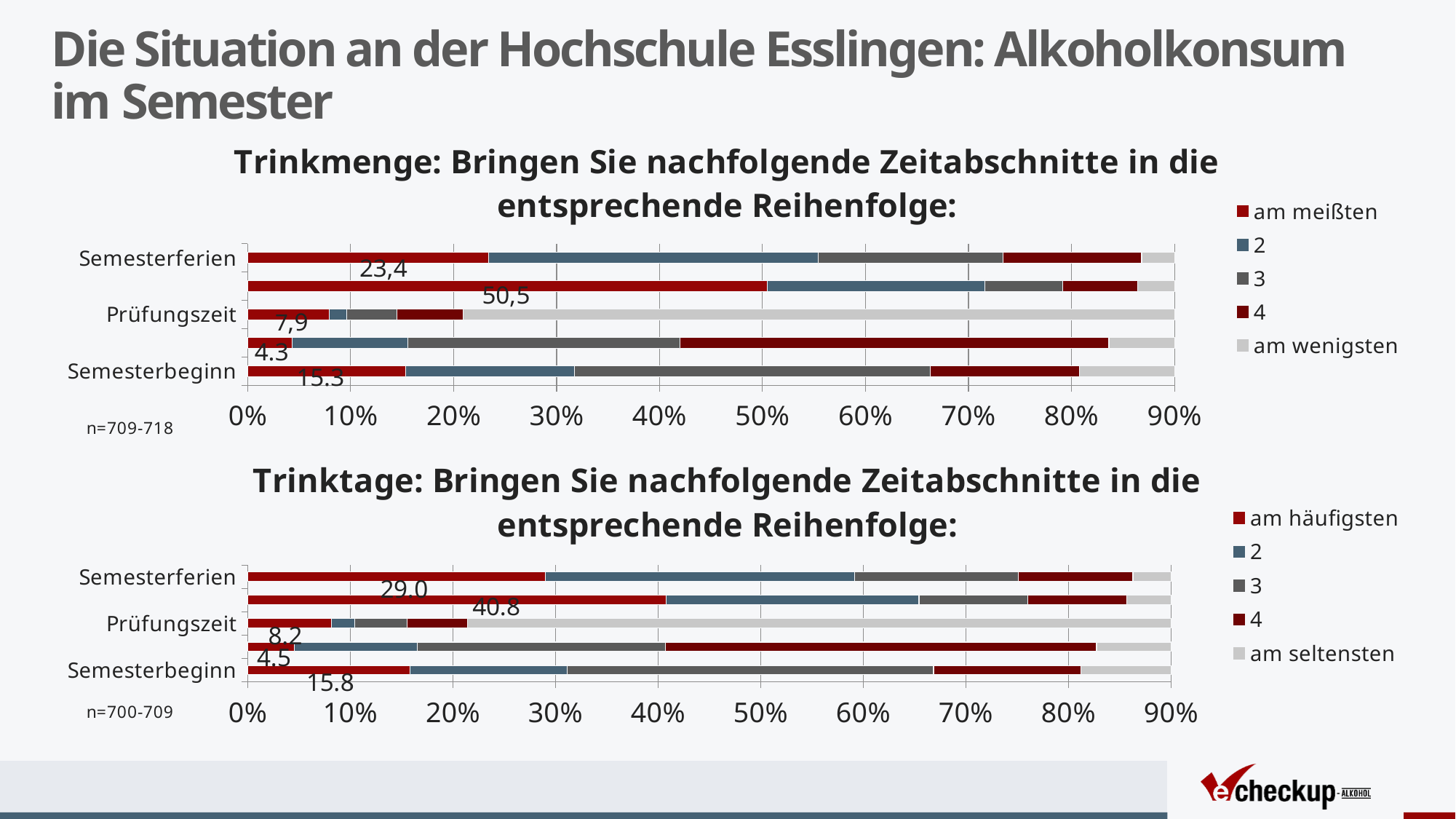
In the bottom chart (Trinktage), what is the value of the 'am häufigsten' segment for Prüfungszeit? 8.2 What is the first legend entry of the top chart (Trinkmenge)? am meißten In the bottom chart (Trinktage), what is the value of the 'am häufigsten' segment for Semesterbeginn? 15.8 How many series does the legend of the bottom chart (Trinktage) list? 5 In the top chart (Trinkmenge), what is the difference between the 'am meißten' values for Semesterferien and Semesterbeginn? 8,1 In the top chart (Trinkmenge), what is the value of the 'am meißten' segment for Semesterferien? 23,4 In the bottom chart (Trinktage), what is the value of the 'am häufigsten' segment for Semesterferien? 29.0 In the top chart (Trinkmenge), what is the value of the 'am meißten' segment for Prüfungszeit? 7,9 What kind of chart is the top chart (Trinkmenge)? Stacked bar chart In the top chart (Trinkmenge), what is the value of the 'am meißten' segment for Semesterbeginn? 15.3 In the top chart (Trinkmenge), which of the labelled categories has the lowest 'am meißten' value? Prüfungszeit In the bottom chart (Trinktage), which is larger: the 'am häufigsten' value for Semesterferien or for Semesterbeginn? Semesterferien